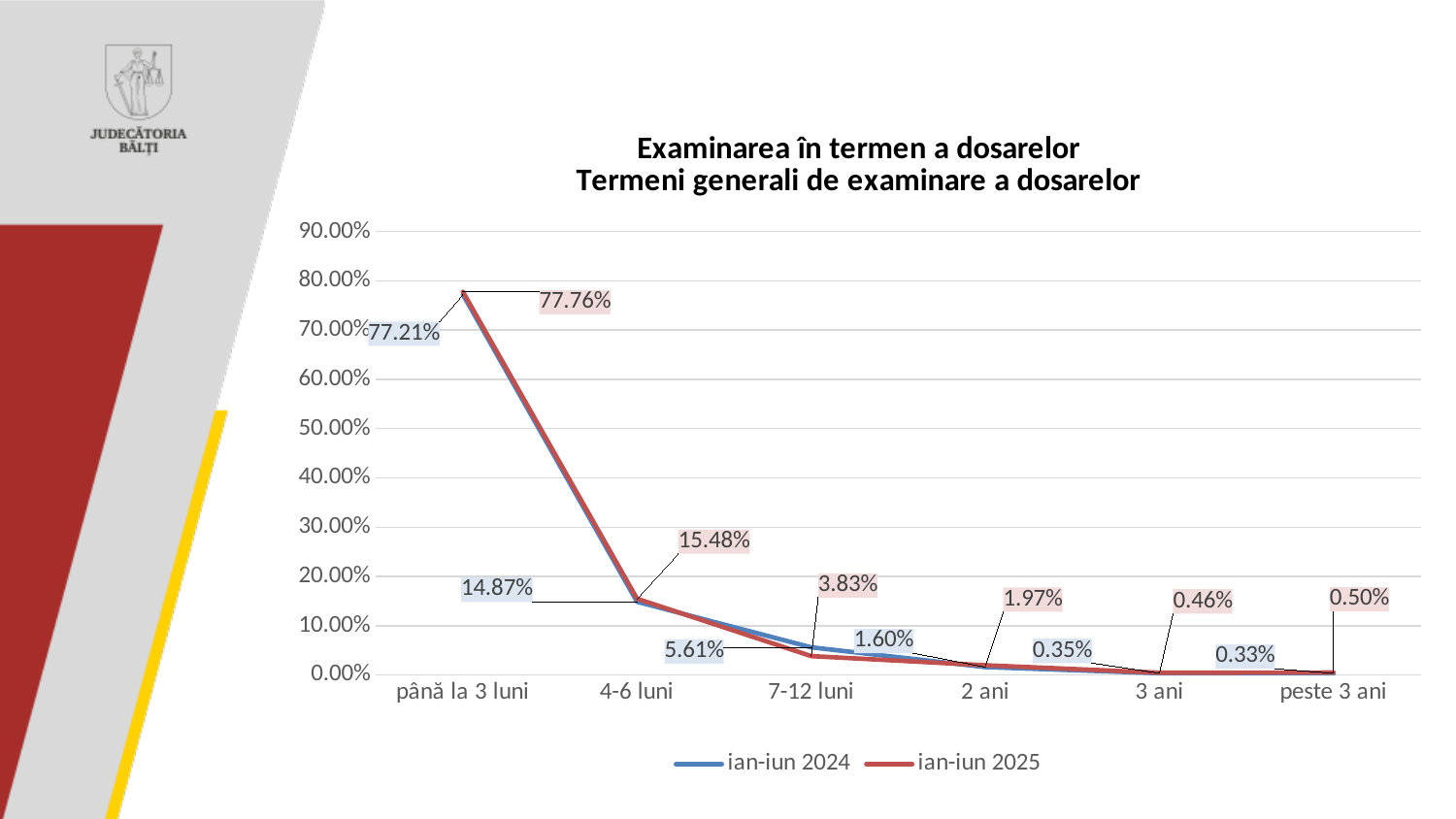
How many categories are shown on the x axis? 6 For '7-12 luni', which series has the larger value, ian-iun 2024 or ian-iun 2025? ian-iun 2024 What is the value for '4-6 luni' in the ian-iun 2024 series? 14.87% Which category has the highest value in the ian-iun 2024 series? până la 3 luni What is the value for 'peste 3 ani' in the ian-iun 2024 series? 0.33% What kind of chart is shown on the slide? line chart Do the values rise or fall along the x axis from 'până la 3 luni' to '3 ani' in the ian-iun 2025 series? fall What is the difference between the ian-iun 2025 and ian-iun 2024 values for '4-6 luni'? 0.61% What is the value for '7-12 luni' in the ian-iun 2025 series? 3.83% Which category has the lowest value in the ian-iun 2025 series? 3 ani How many series does the legend list? 2 What is the value for 'până la 3 luni' in the ian-iun 2025 series? 77.76%